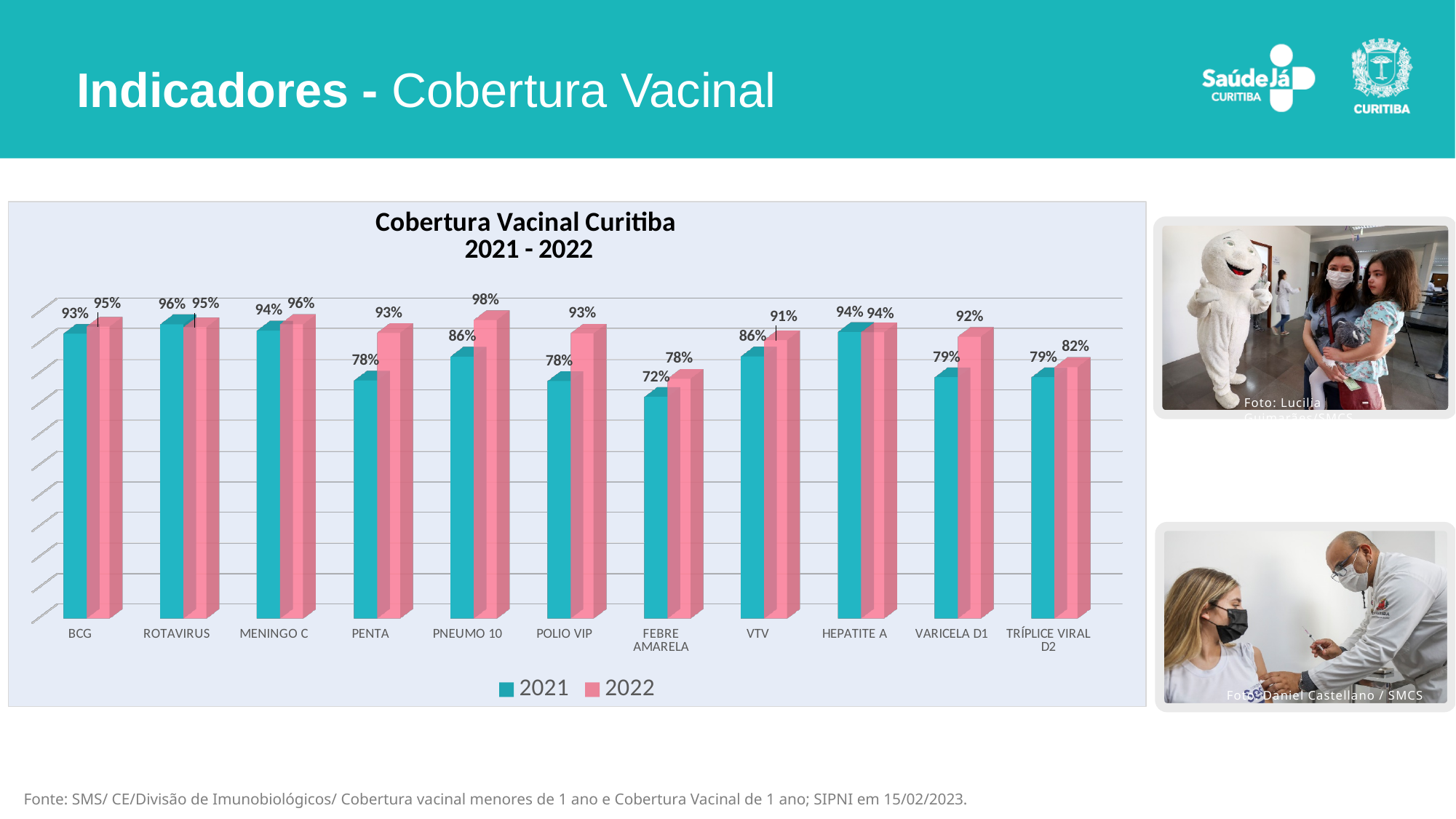
Which colour represents the 2022 series? Pink How many vaccine categories are shown on the x axis? 11 Which is larger for ROTAVIRUS, the 2021 value or the 2022 value? 2021 What is the 2021 value for VARICELA D1? 79% What kind of chart is shown? Bar chart What is the 2021 value for FEBRE AMARELA? 72% How many series does the legend list? 2 What is the difference between the 2022 and 2021 values for PENTA? 15% Which category has the lowest 2021 value? FEBRE AMARELA Which category has the highest 2022 value? PNEUMO 10 What is the 2022 value for PNEUMO 10? 98% What is the title of the chart? Cobertura Vacinal Curitiba 2021 - 2022